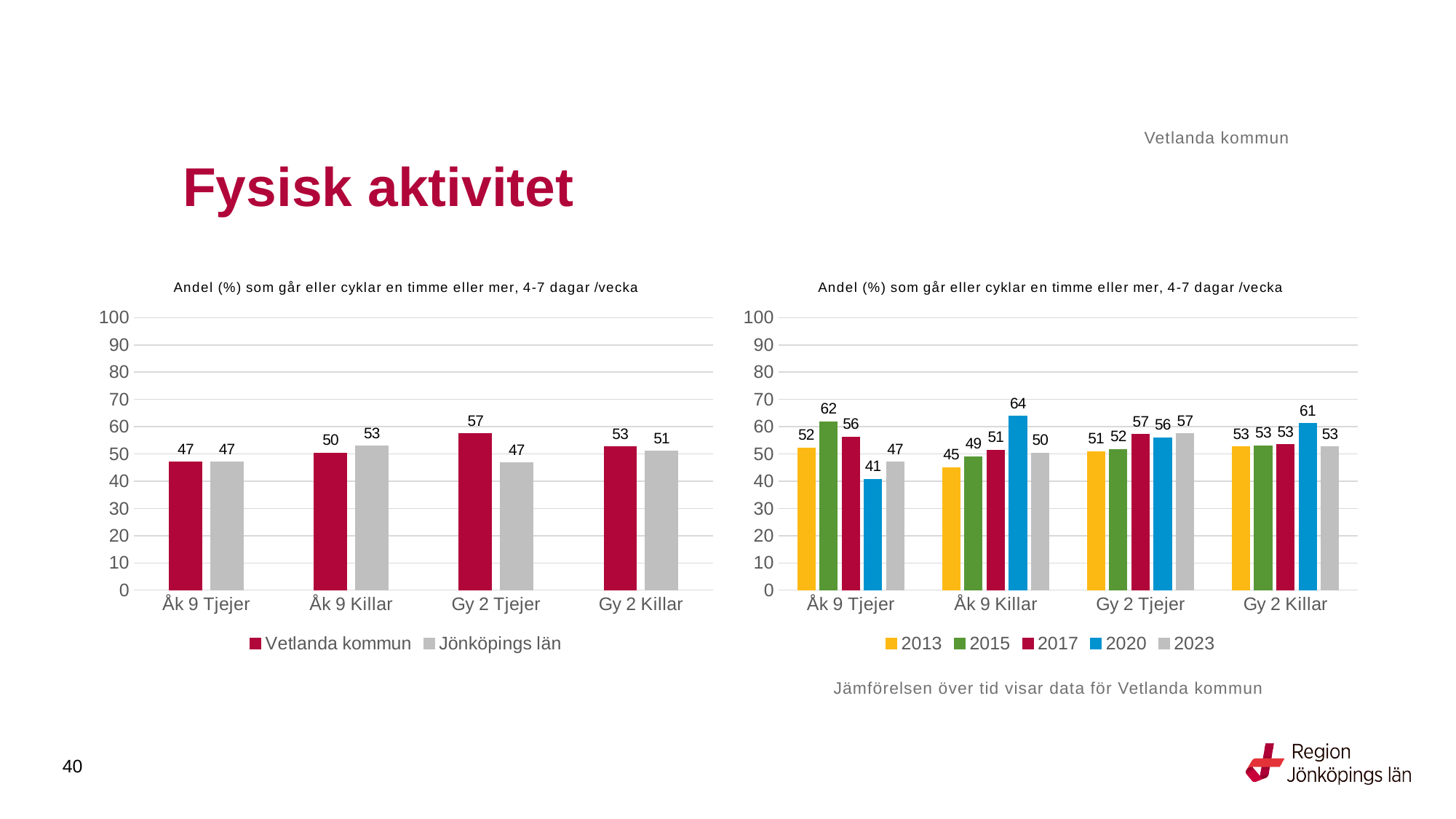
In the right chart, how many series does the legend list? 5 In the right chart, what is the value for 2020 for Åk 9 Killar? 64 In the left chart, which category has the highest value for Vetlanda kommun? Gy 2 Tjejer What kind of chart is the left chart? Bar chart In the left chart, what is the difference between Vetlanda kommun and Jönköpings län for Gy 2 Tjejer? 10 In the left chart, what is the value for Vetlanda kommun for Gy 2 Tjejer? 57 In the right chart, what is the value for 2013 for Åk 9 Tjejer? 52 In the left chart, what is the value for Jönköpings län for Åk 9 Killar? 53 In the right chart, which year has the lowest value for Åk 9 Tjejer? 2020 In the right chart, which is larger for Gy 2 Killar: 2020 or 2023? 2020 In the left chart, how many series does the legend list? 2 In the right chart, what is the difference between 2015 and 2020 for Åk 9 Tjejer? 21